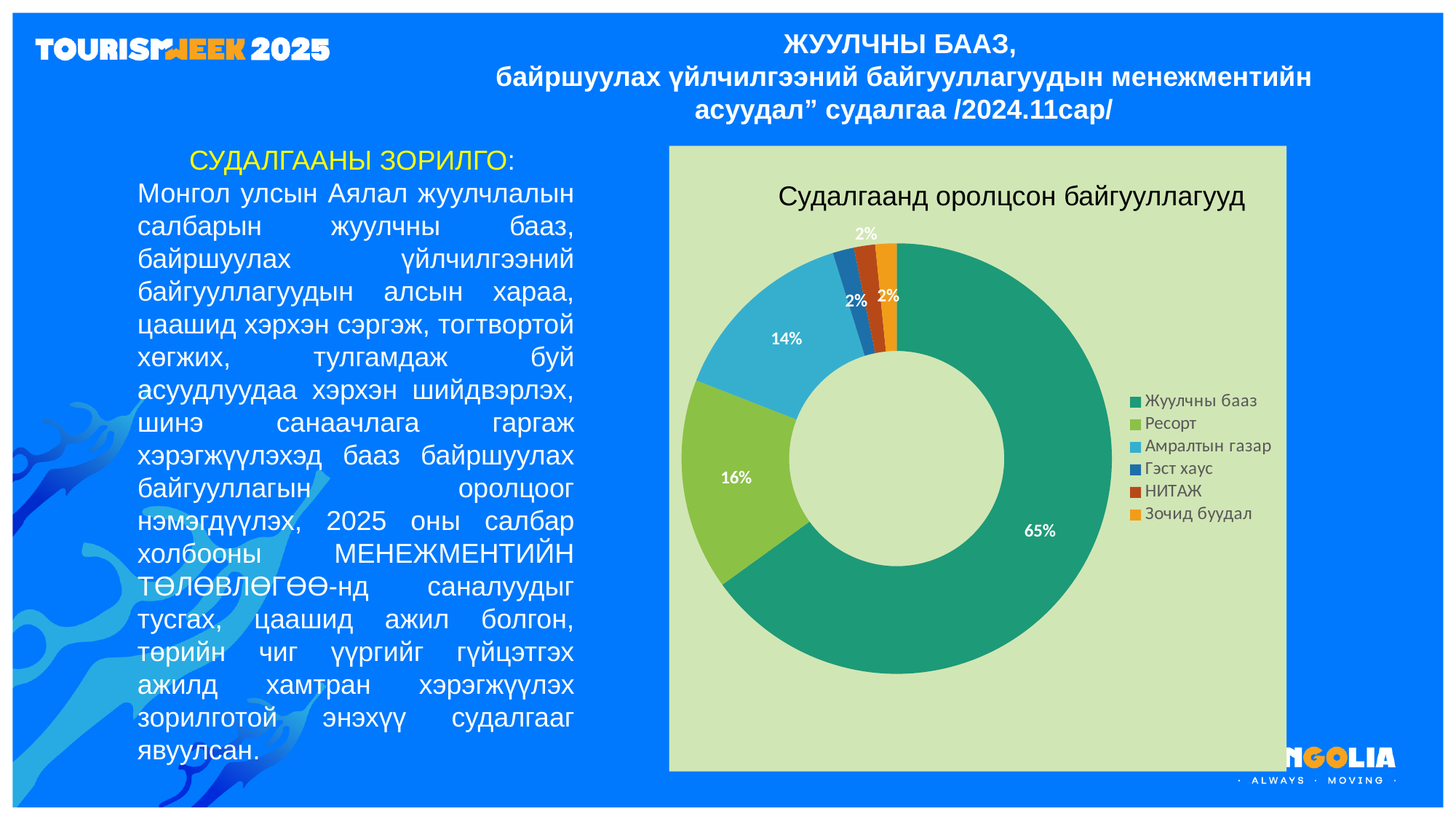
What share of the chart does Жуулчны бааз represent? 65% What is the difference in percentage points between Ресорт and Амралтын газар? 2 percentage points What is the difference in percentage points between Жуулчны бааз and Ресорт? 49 percentage points What is the value shown for Зочид буудал? 2% Which is larger, the share for Ресорт or the share for Амралтын газар? Ресорт What is the title of the chart? Судалгаанд оролцсон байгууллагууд Which colour represents Жуулчны бааз in the chart? Dark green (teal) What is the value shown for Амралтын газар? 14% How many categories does the chart's legend list? 6 What is the value shown for Ресорт? 16% Which category has the largest share of the chart? Жуулчны бааз What type of chart is shown on the slide? Doughnut (pie) chart